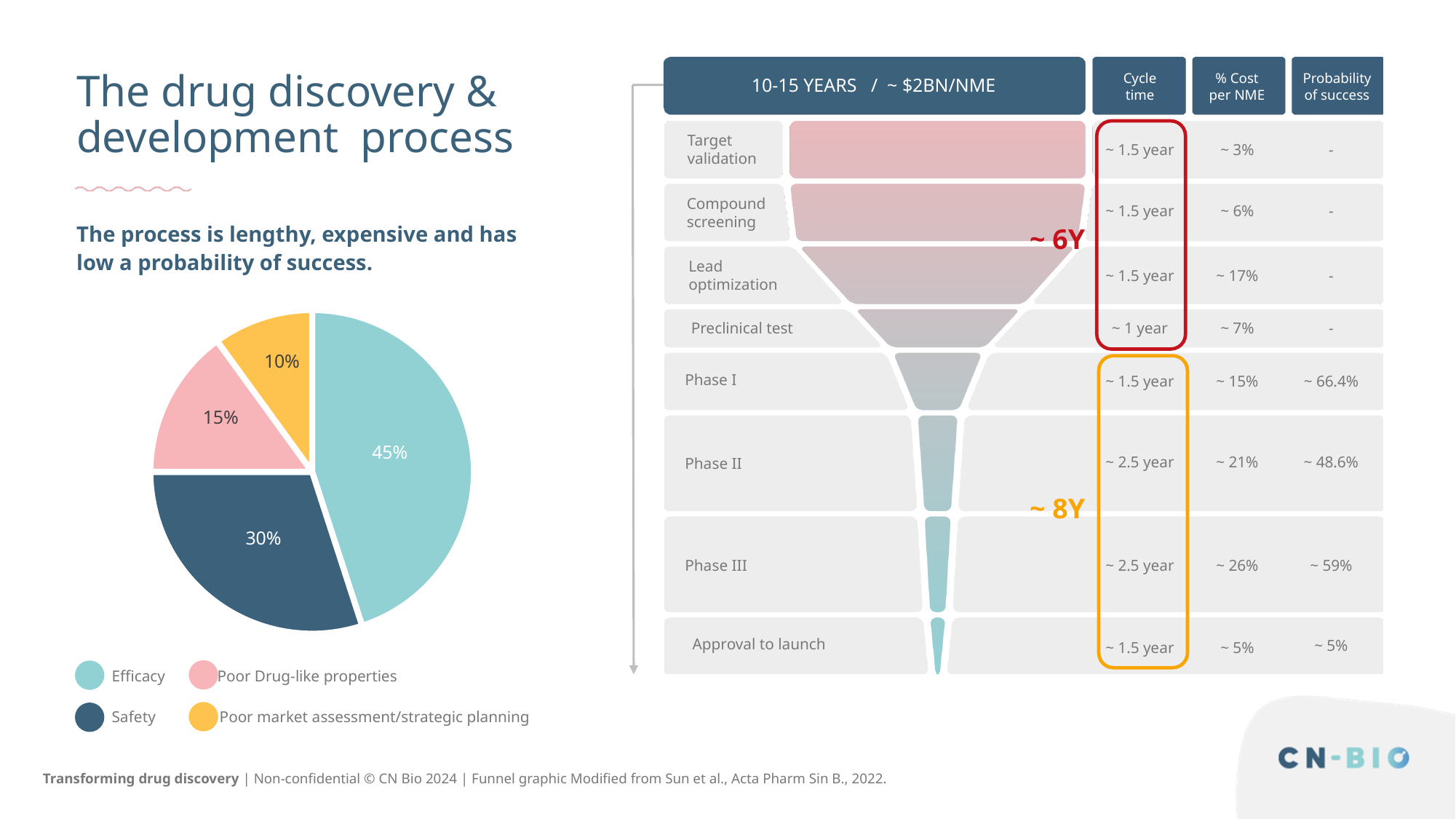
In the pie chart, what share is labelled for Poor Drug-like properties? 15% Which category has the smallest slice in the pie chart? Poor market assessment/strategic planning How many slices does the pie chart have? 4 In the pie chart, what is the combined share of Poor Drug-like properties and Poor market assessment/strategic planning? 25% In the pie chart, what share is labelled for Safety? 30% Which category has the largest slice in the pie chart? Efficacy What kind of chart is shown on the left of the slide? Pie chart In the pie chart, what is the difference in percentage points between Efficacy and Safety? 15 In the pie chart, what share is labelled for Poor market assessment/strategic planning? 10% In the pie chart, what share is labelled for Efficacy? 45% In the pie chart, which is larger: Safety or Poor Drug-like properties? Safety What colour is the Safety slice in the pie chart? Dark blue